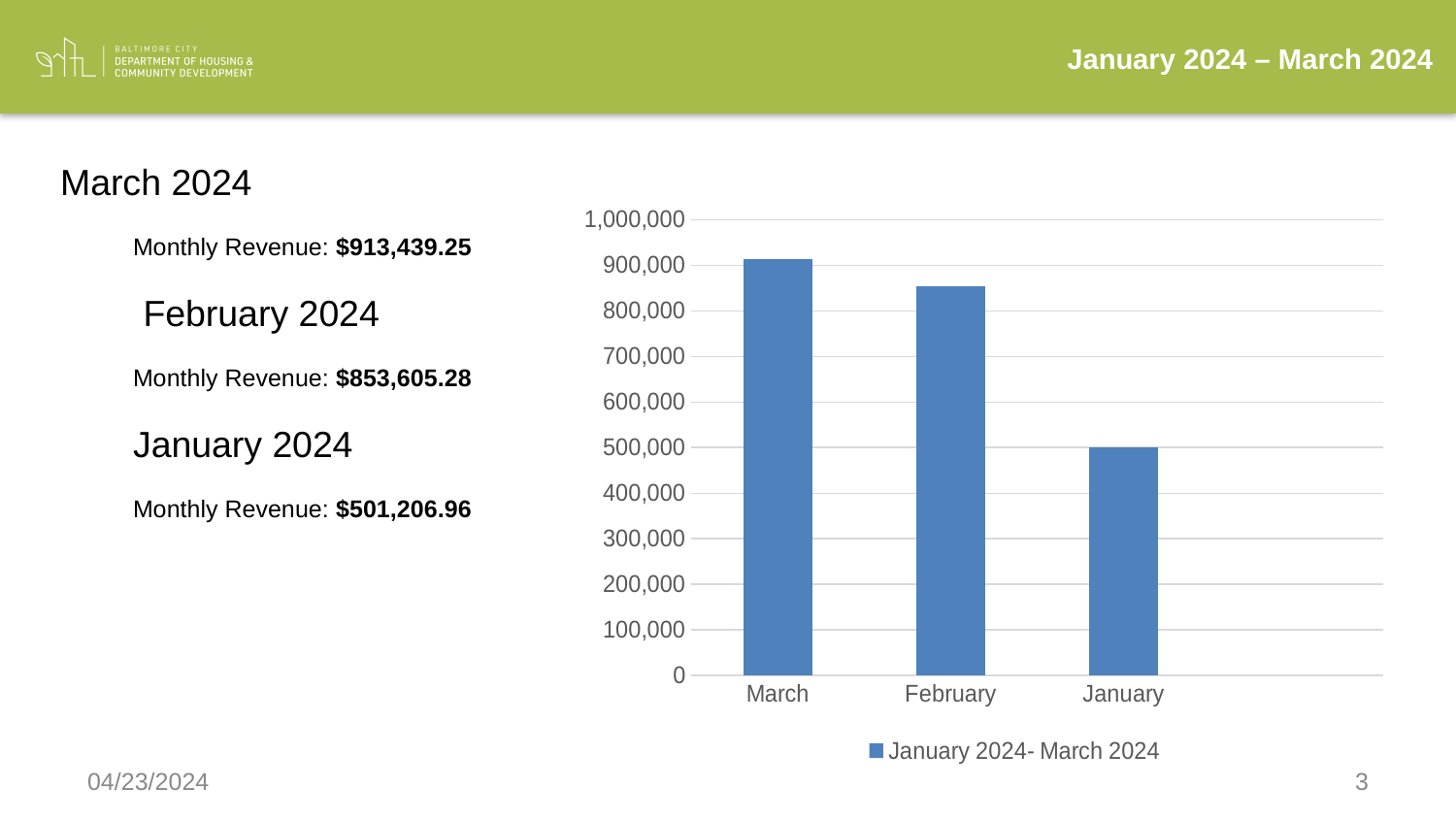
How many series does the chart legend list? 1 Which month has the highest bar in the chart? March How many bars (categories) does the chart show? 3 What kind of chart is shown on the slide? bar chart According to the slide text, what is the monthly revenue for March 2024? $913,439.25 Is the value for March greater or less than 900,000? greater Which is larger, the bar for February or the bar for January? February Is the value for February greater or less than 800,000? greater Which month has the lowest bar in the chart? January Do the bar values rise or fall moving left to right from March to January? fall What is the legend entry for the series in the chart? January 2024- March 2024 Is the value for January greater or less than 600,000? less